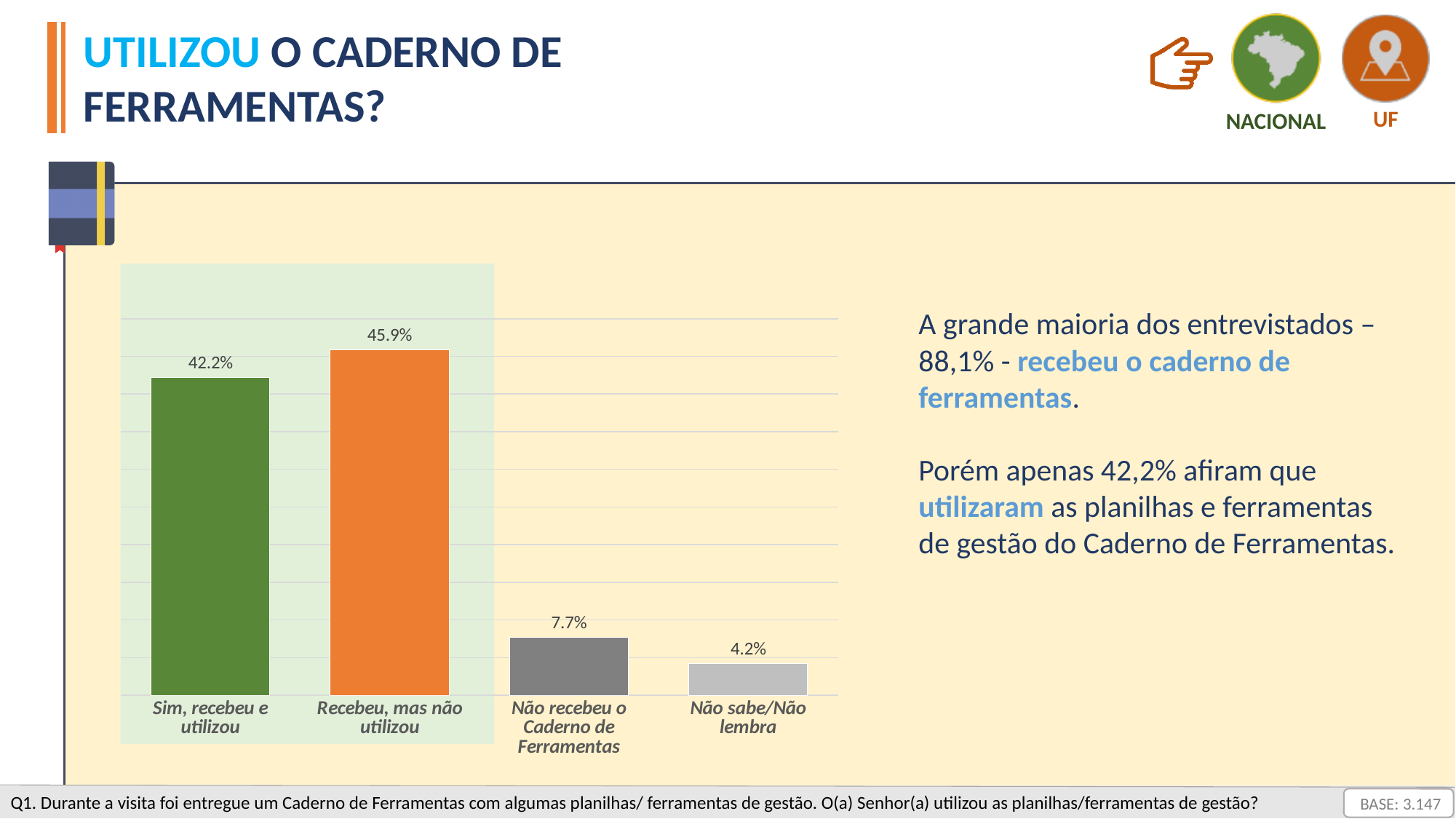
Which category has the highest value? Recebeu, mas não utilizou What is the value for "Não recebeu o Caderno de Ferramentas"? 7.7% What kind of chart is shown on the slide? Bar chart What is the difference between "Recebeu, mas não utilizou" and "Sim, recebeu e utilizou"? 3.7% How many categories are shown in the chart? 4 What is the value for "Não sabe/Não lembra"? 4.2% Which category has the lowest value? Não sabe/Não lembra What is the value for "Recebeu, mas não utilizou"? 45.9% Which is larger: "Não recebeu o Caderno de Ferramentas" or "Não sabe/Não lembra"? Não recebeu o Caderno de Ferramentas What is the value for "Sim, recebeu e utilizou"? 42.2% What colour is the bar for "Recebeu, mas não utilizou"? Orange What is the combined value of "Sim, recebeu e utilizou" and "Recebeu, mas não utilizou"? 88.1%